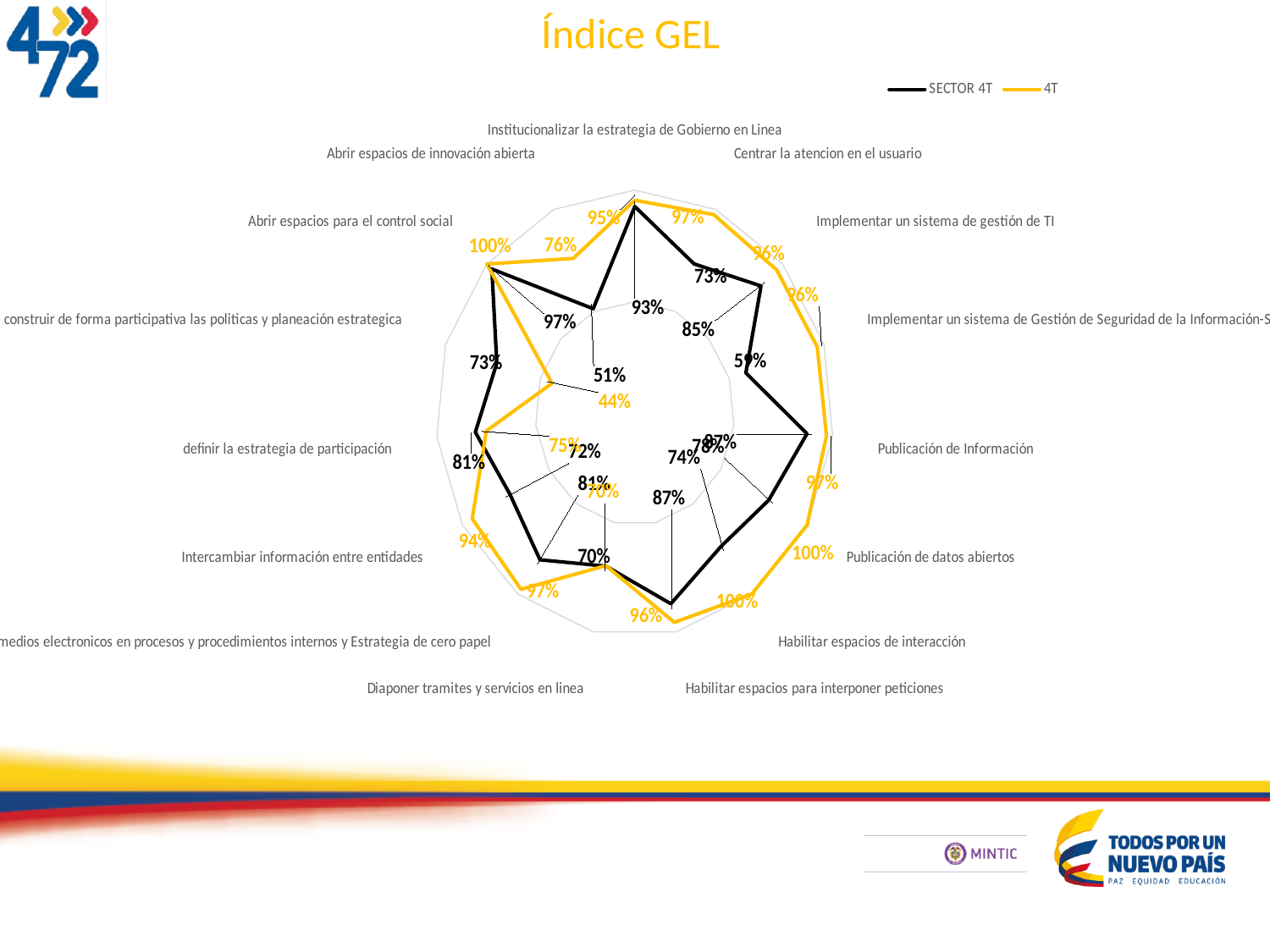
What is the 4T value for Publicación de datos abiertos? 100% What is the 4T value for Habilitar espacios de interacción? 100% What is the SECTOR 4T value for Centrar la atencion en el usuario? 73% For Centrar la atencion en el usuario, which series has the larger value, SECTOR 4T or 4T? 4T What is the difference between the 4T and SECTOR 4T values for Centrar la atencion en el usuario? 24% How many series does the legend list? 2 What is the 4T value for Abrir espacios para el control social? 100% What is the 4T value for Centrar la atencion en el usuario? 97% How many categories (axes) does the radar chart have? 15 What kind of chart is shown on the slide? Radar chart Which two series are listed in the legend? SECTOR 4T and 4T What is the title of the chart? Índice GEL